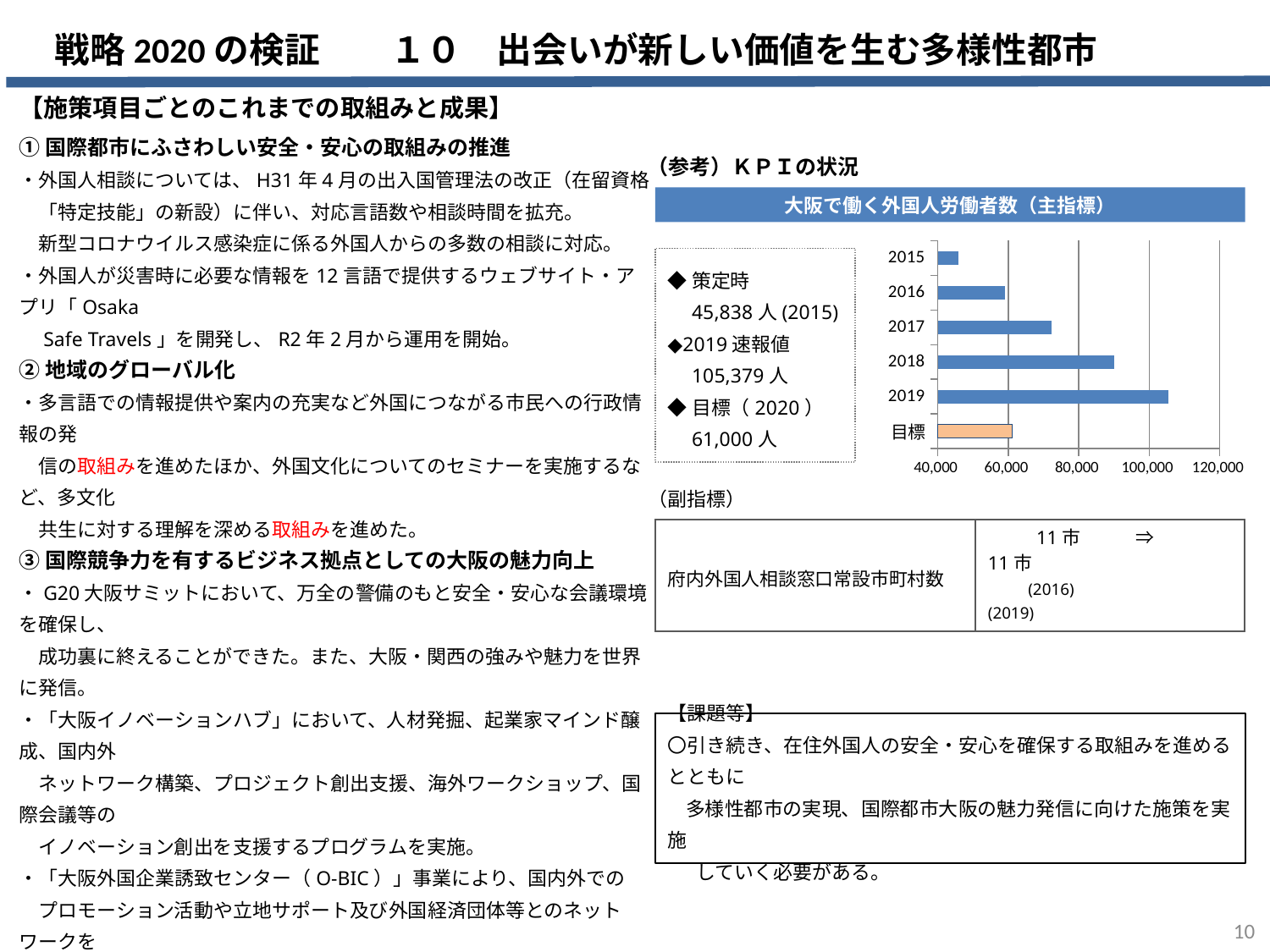
Which category has the longest bar in the 大阪で働く外国人労働者数 chart? 2019 In the 大阪で働く外国人労働者数 chart, is the bar for 2015 greater or less than 60,000? less In the 大阪で働く外国人労働者数 chart, which bar is longer, 2017 or 2018? 2018 How many bars are plotted in the 大阪で働く外国人労働者数 chart? 6 Which category has the shortest bar in the 大阪で働く外国人労働者数 chart? 2015 According to the KPI box next to the chart, what was the value for 2015 (策定時)? 45,838 人 Do the values in the 大阪で働く外国人労働者数 chart rise or fall from 2015 to 2019? rise In the 大阪で働く外国人労働者数 chart, is the bar for 2017 greater or less than 80,000? less In the 大阪で働く外国人労働者数 chart, is the bar for 2019 greater or less than 100,000? greater In the 大阪で働く外国人労働者数 chart, which bar is drawn in a different colour (orange) from the others? 目標 What kind of chart is shown under the heading 大阪で働く外国人労働者数（主指標）? bar chart